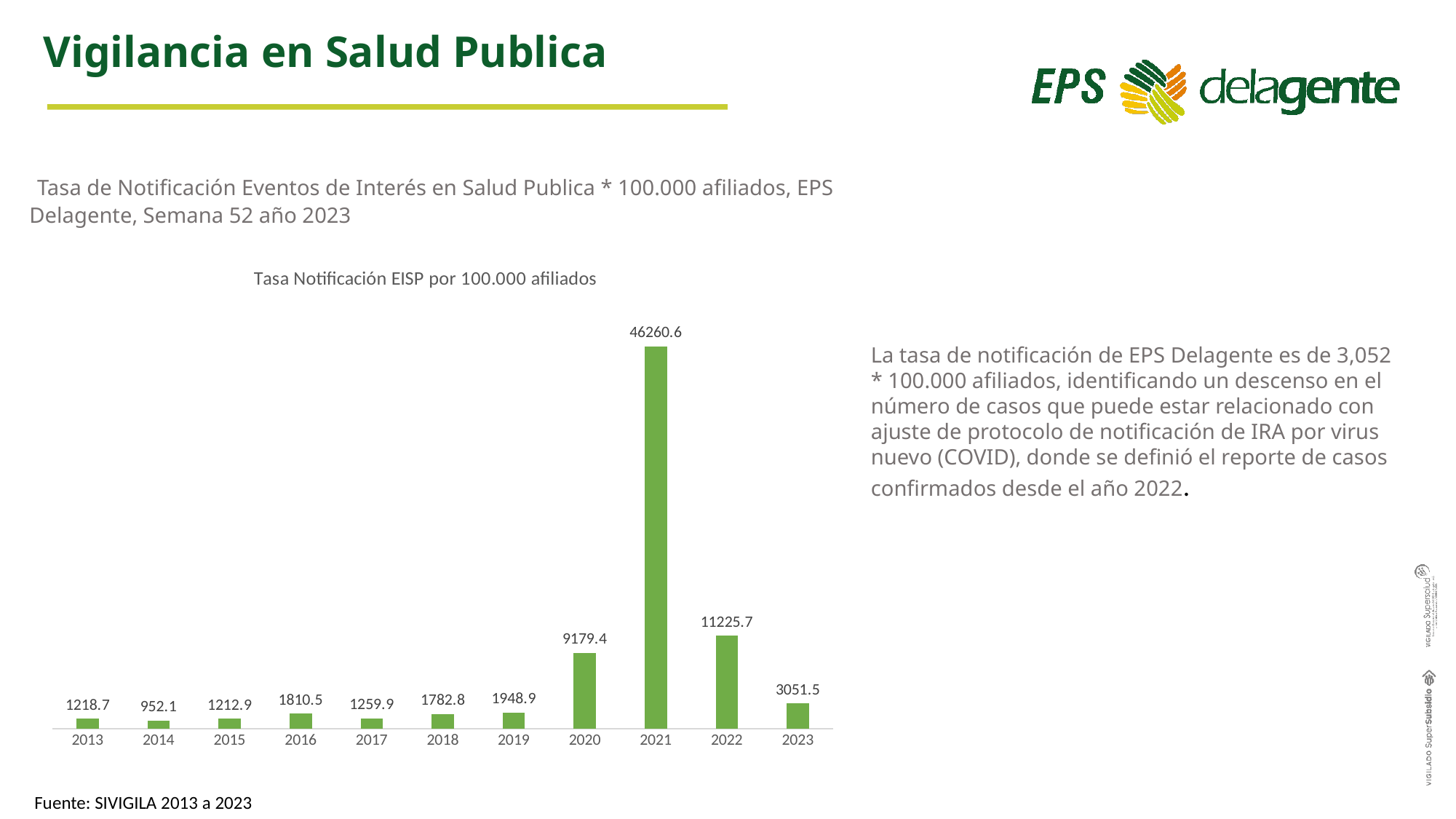
Which is larger, the value for 2016 or the value for 2017? 2016 Do the values rise or fall from 2021 to 2023? Fall Which year has the lowest value in the chart? 2014 What is the value for 2014 in the chart? 952.1 What is the value for 2023 in the chart? 3051.5 What is the difference between the values for 2022 and 2023? 8174.2 What kind of chart is shown on the slide? Bar chart What is the difference between the values for 2021 and 2020? 37081.2 Which year has the highest value in the chart? 2021 What is the value for 2021 in the chart? 46260.6 What is the value for 2020 in the chart? 9179.4 How many years are shown on the x axis of the chart? 11